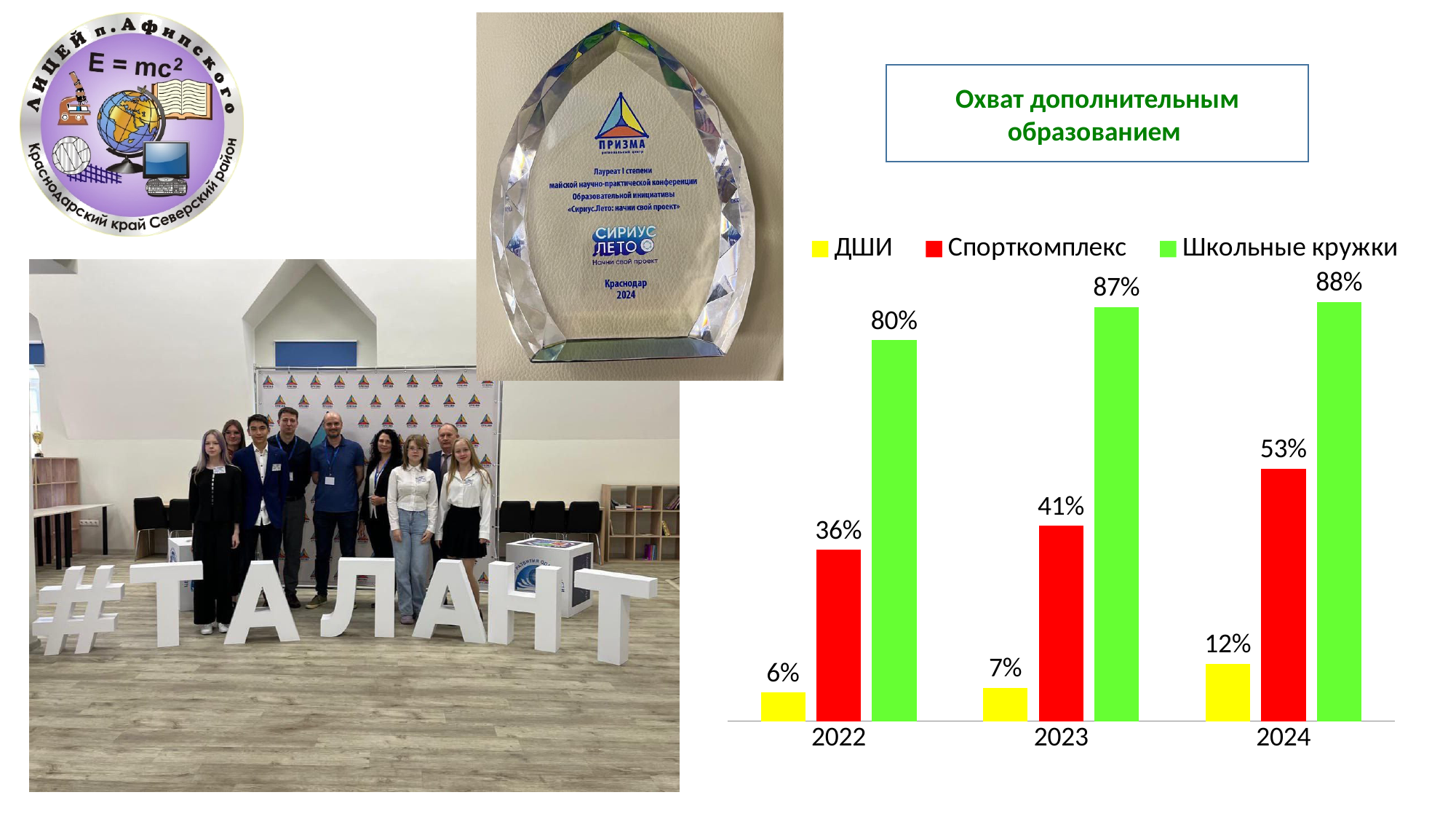
What is the value for ДШИ in 2022? 6% Which year has the highest value for Спорткомплекс? 2024 What is the value for Школьные кружки in 2024? 88% How many series does the legend list? 3 Which year has the lowest value for ДШИ? 2022 What kind of chart is shown? Bar chart How many years are shown on the x axis? 3 Do the values for ДШИ rise or fall from 2022 to 2024? Rise What colour represents Спорткомплекс in the chart? Red Which is larger: Школьные кружки in 2022 or Спорткомплекс in 2024? Школьные кружки in 2022 What is the difference between the Спорткомплекс values in 2024 and 2022? 17% What is the value for Спорткомплекс in 2023? 41%